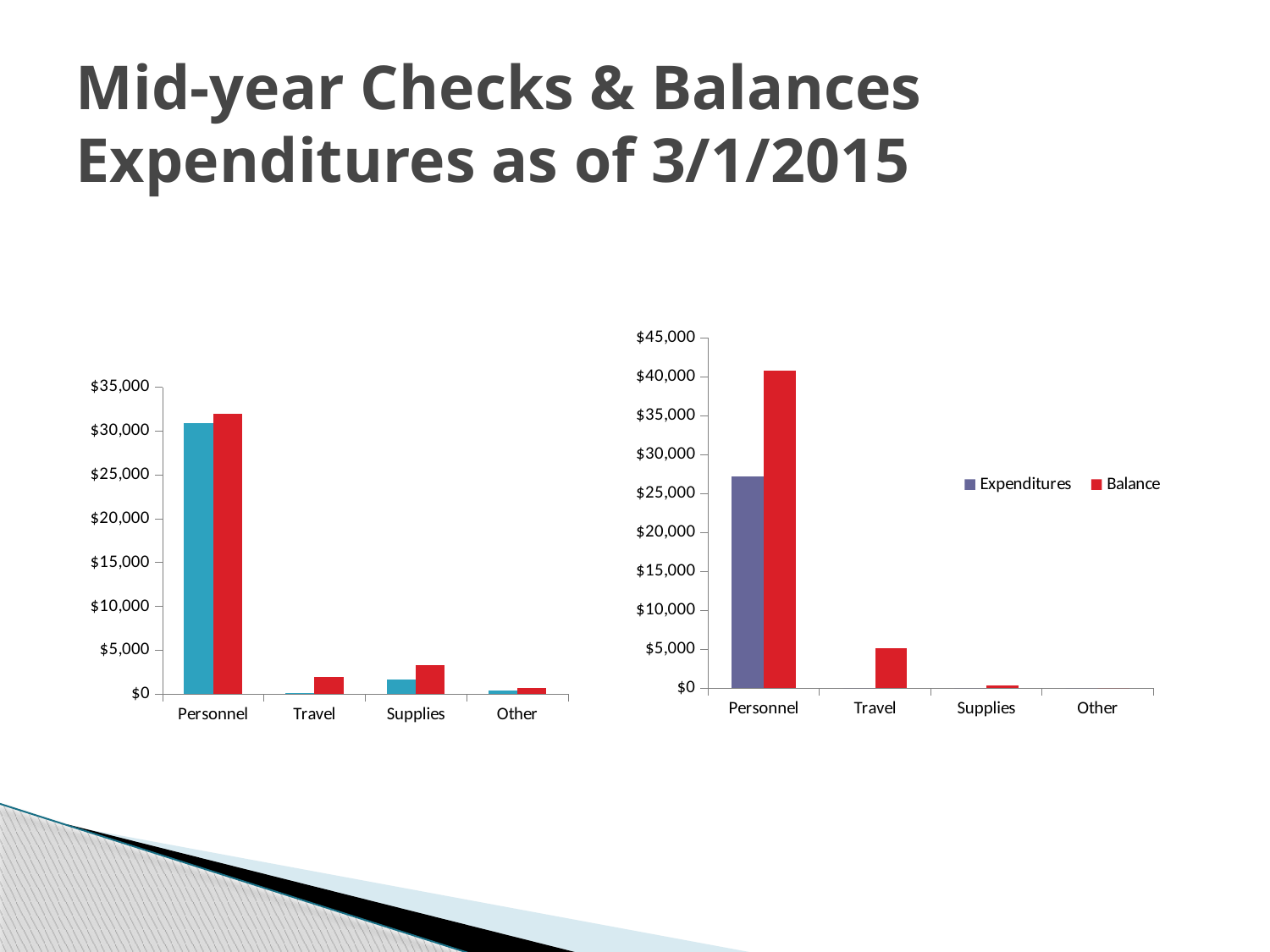
In the chart on the right of the slide, is the Balance value for Travel greater or less than $10,000? less In the chart on the right of the slide, is the Expenditures value for Personnel greater or less than $30,000? less How many categories are shown on the x axis of the chart on the left of the slide? 4 In the chart on the right of the slide, which is larger for Personnel, Expenditures or Balance? Balance What are the two legend entries of the chart on the right of the slide? Expenditures and Balance In the chart on the right of the slide, is the Balance value for Personnel greater or less than $35,000? greater What kind of chart is the chart on the right of the slide? bar chart In the chart on the left of the slide, which category has the tallest bars? Personnel How many series does the legend of the chart on the right of the slide list? 2 In the chart on the right of the slide, which category has the highest Balance value? Personnel